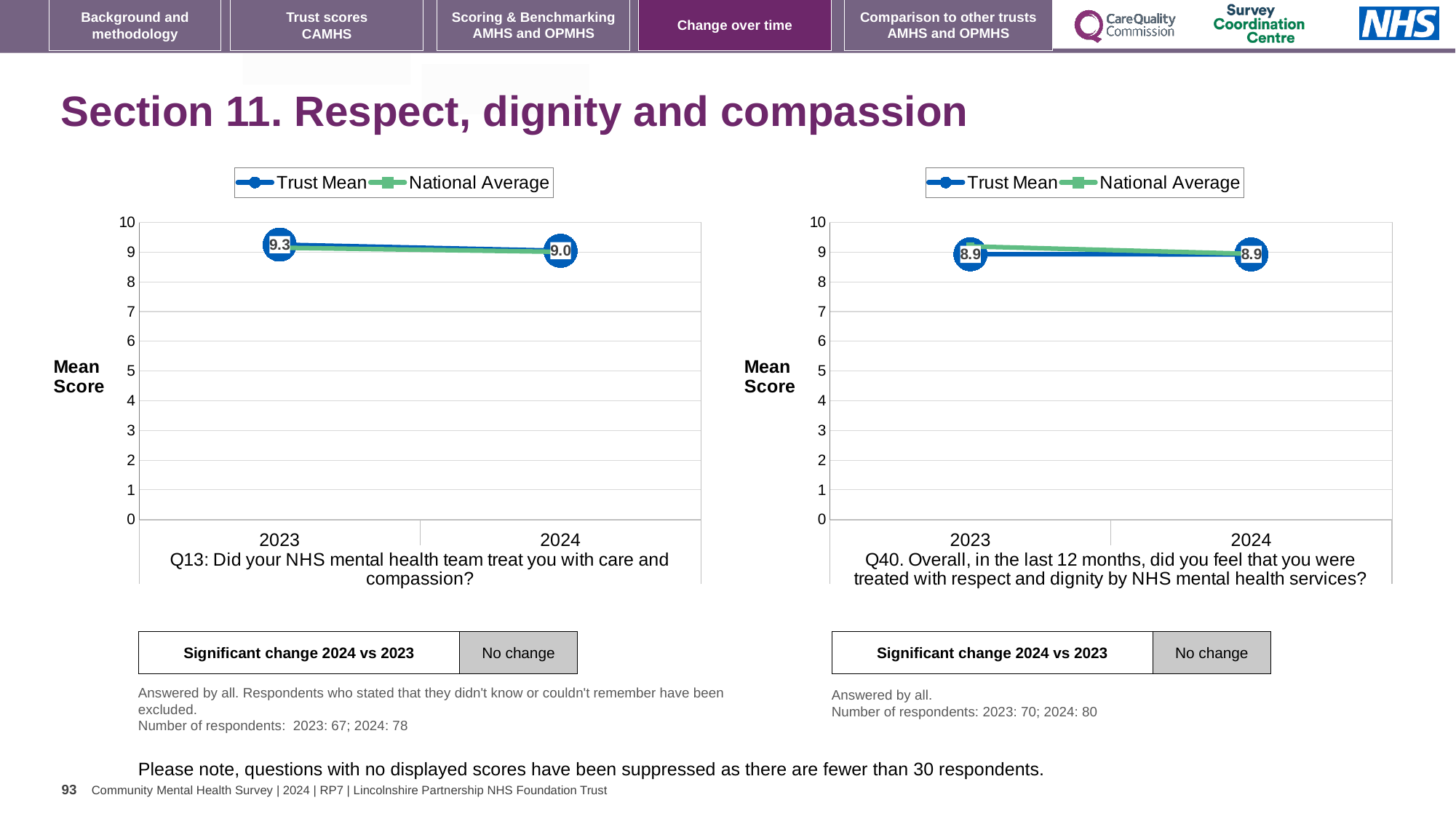
In the Q13 chart on the left, by how much did the Trust Mean change from 2023 to 2024? 0.3 In the Q13 chart on the left, is the National Average for 2023 greater or less than 8? greater In the Q13 chart on the left, what is the Trust Mean for 2024? 9.0 How many series does the legend of the Q13 chart on the left list? 2 In the Q13 chart on the left, what is the Trust Mean for 2023? 9.3 How many years are shown on the x axis of the Q40 chart on the right? 2 What kind of chart is the Q40 chart on the right? line chart In the Q40 chart on the right, is the National Average for 2024 greater or less than 8? greater In the Q40 chart on the right, what is the Trust Mean for 2023? 8.9 In the Q13 chart on the left, does the Trust Mean rise or fall from 2023 to 2024? fall In the Q13 chart on the left, which year has the higher Trust Mean, 2023 or 2024? 2023 In the Q40 chart on the right, what is the Trust Mean for 2024? 8.9